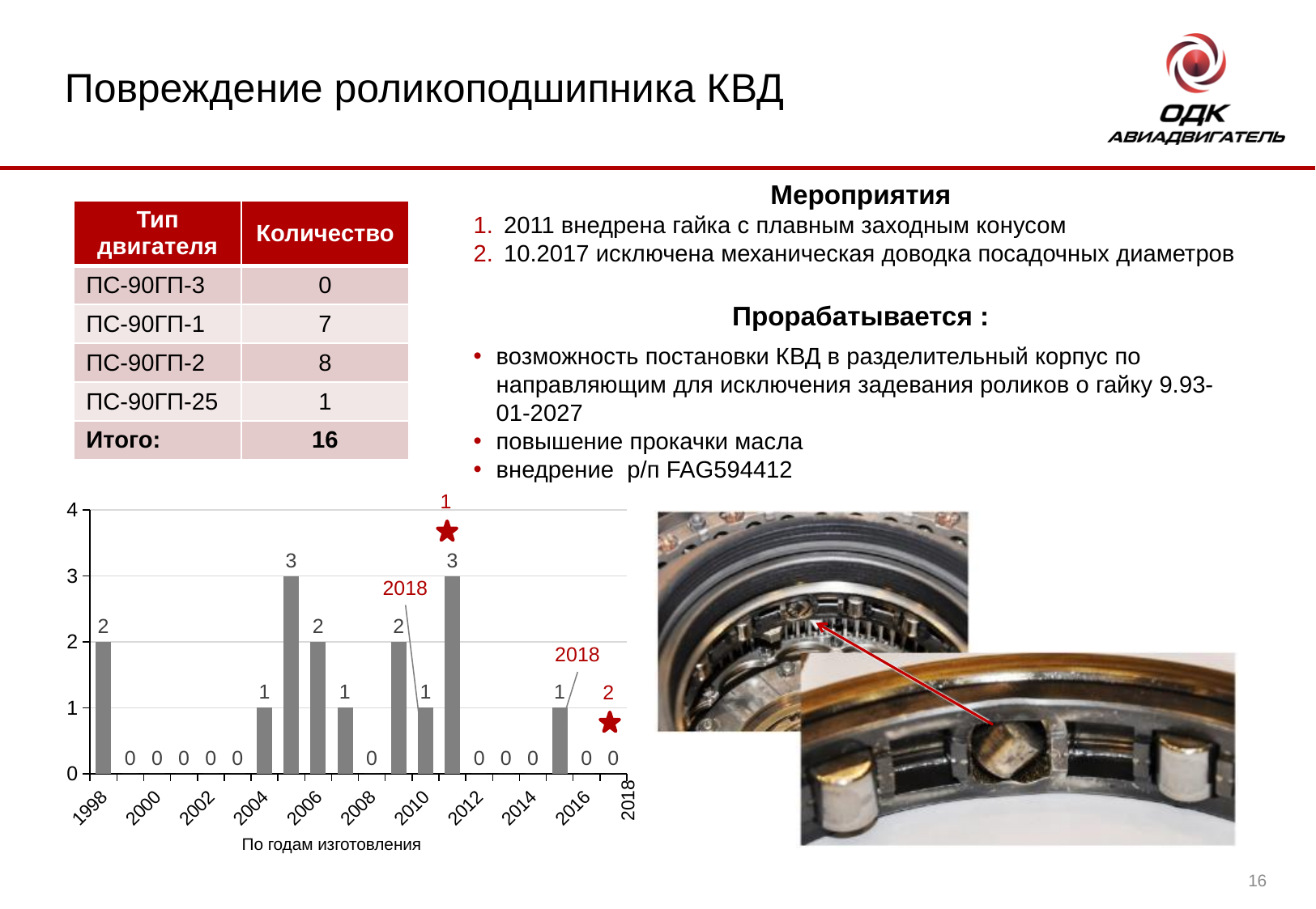
In the bar chart, what is the highest value reached by any bar? 3 In the bar chart, what is the value for 2016? 0 In the bar chart, what is the value for 1998? 2 What is the caption under the x axis of the bar chart? По годам изготовления What type of chart is shown at the bottom left of the slide? bar chart In the bar chart, what is the difference between the values for 2005 and 2006? 1 In the bar chart, how many years have a value of 3? 2 In the bar chart, what is the value for 2010? 1 In the bar chart, what is the value for 2004? 1 In the bar chart, which year has the larger value, 1998 or 2004? 1998 What is the maximum value shown on the y axis of the bar chart? 4 In the bar chart, what is the value for 2006? 2